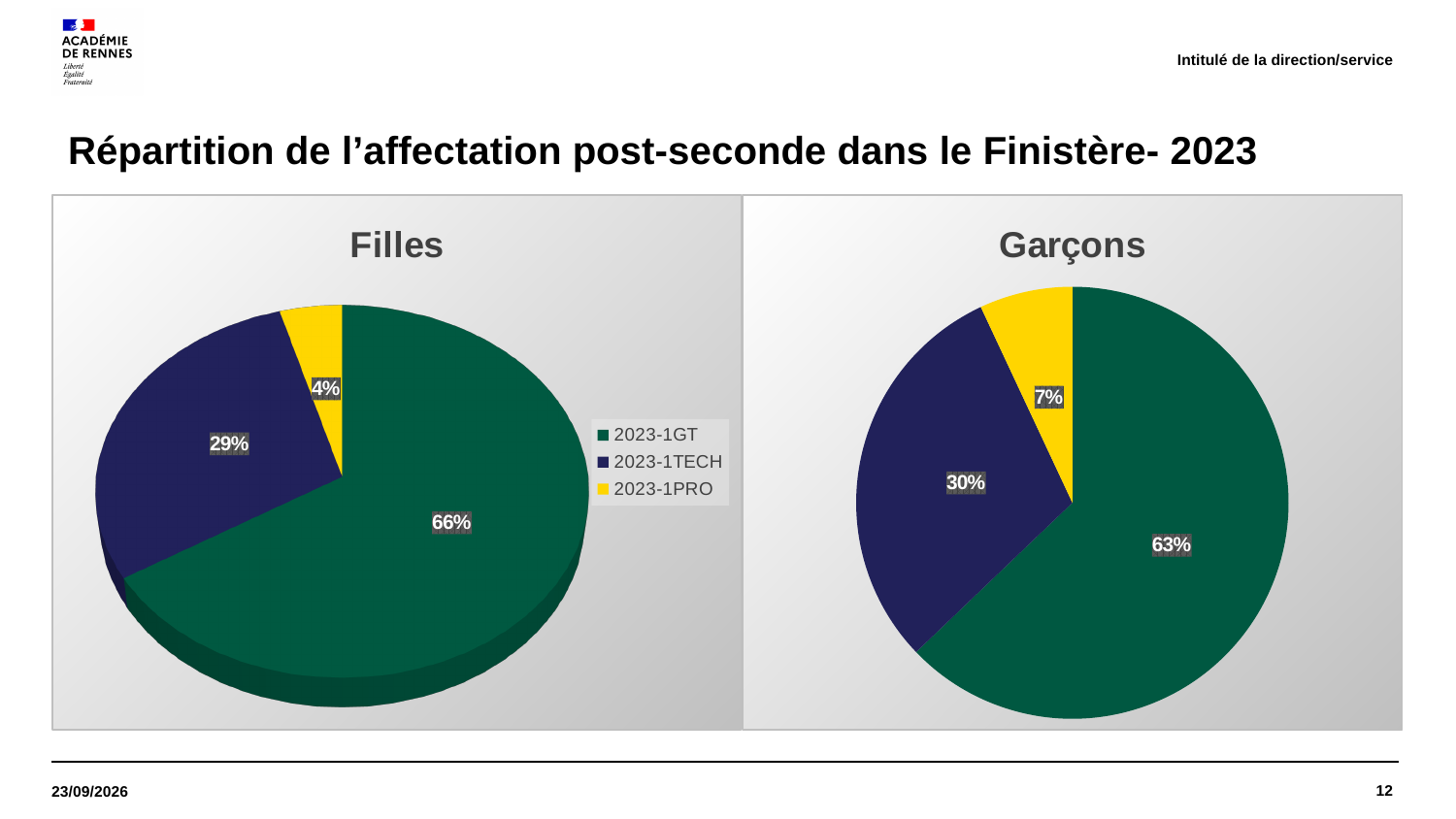
What is the difference between the 2023-1GT share in the Filles chart and the 2023-1GT share in the Garçons chart? 3% In the Garçons chart, what is the value for 2023-1TECH? 30% In the Filles chart, what is the value for 2023-1PRO? 4% What kind of chart is the Filles chart? Pie chart Which is larger: the 2023-1PRO share in the Filles chart or in the Garçons chart? Garçons In the Garçons chart, what is the value for 2023-1PRO? 7% In the Filles chart, what is the value for 2023-1TECH? 29% In the Garçons chart, what share of the pie is 2023-1GT? 63% In the Filles chart, what share of the pie is 2023-1GT? 66% In the Garçons chart, which category has the largest slice? 2023-1GT In the Filles chart, which category has the smallest slice? 2023-1PRO How many categories does the legend of the Filles chart list? 3